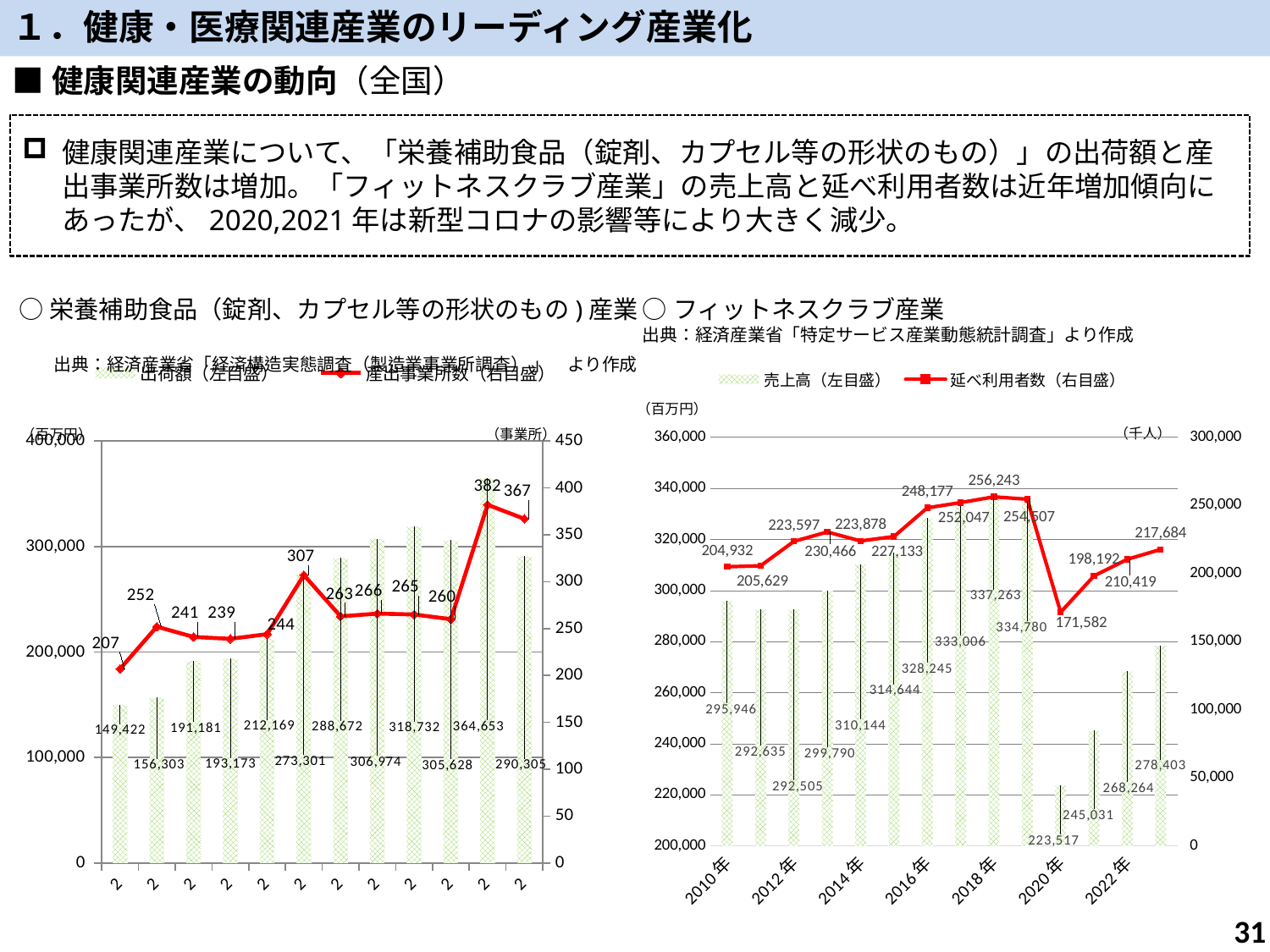
In the フィットネスクラブ産業 chart on the right, what is the difference in 売上高 between 2018年 and 2020年? 113,746 In the フィットネスクラブ産業 chart on the right, what is the 延べ利用者数 value for 2020年? 171,582 In the 栄養補助食品 chart on the left, what is the lowest 出荷額 value shown on the bars? 149,422 What kind of chart is the 栄養補助食品 chart on the left? A combined bar and line chart In the フィットネスクラブ産業 chart on the right, which year has the lowest 売上高? 2020年 In the 栄養補助食品 chart on the left, what is the highest 産出事業所数 value shown on the line? 382 In the 栄養補助食品 chart on the left, how many bars are plotted? 12 In the フィットネスクラブ産業 chart on the right, which year has the highest 延べ利用者数? 2018年 In the フィットネスクラブ産業 chart on the right, what is the 売上高 value for 2018年? 337,263 In the フィットネスクラブ産業 chart on the right, how many series does the legend list? 2 In the フィットネスクラブ産業 chart on the right, is the 売上高 for 2016年 larger than for 2022年? Yes, 2016年 (328,245) is larger than 2022年 (268,264) In the フィットネスクラブ産業 chart on the right, what is the 売上高 value for 2010年? 295,946